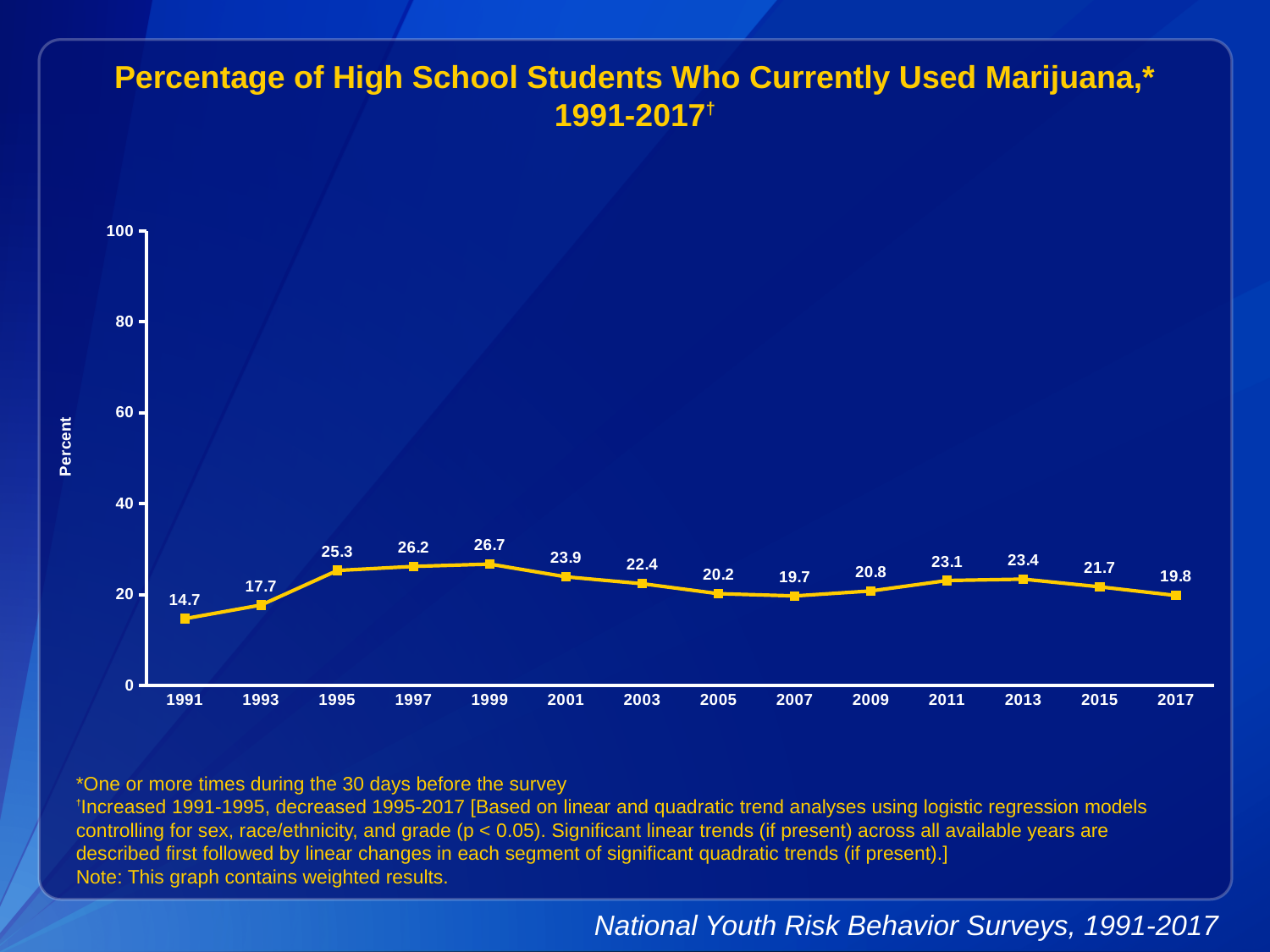
What is the difference between the values for 1999 and 1991? 12 What is the label on the y axis? Percent What is the difference between the values for 1995 and 2017? 5.5 Which year has the lowest percentage? 1991 Is the value for 1993 greater or less than 20? less What is the value plotted for 2017? 19.8 What is the value plotted for 2007? 19.7 What kind of chart is shown on the slide? line chart How many years are plotted on the chart? 14 Which year has the highest percentage? 1999 Which year has the larger value, 2011 or 2015? 2011 What percentage of high school students currently used marijuana in 1991? 14.7